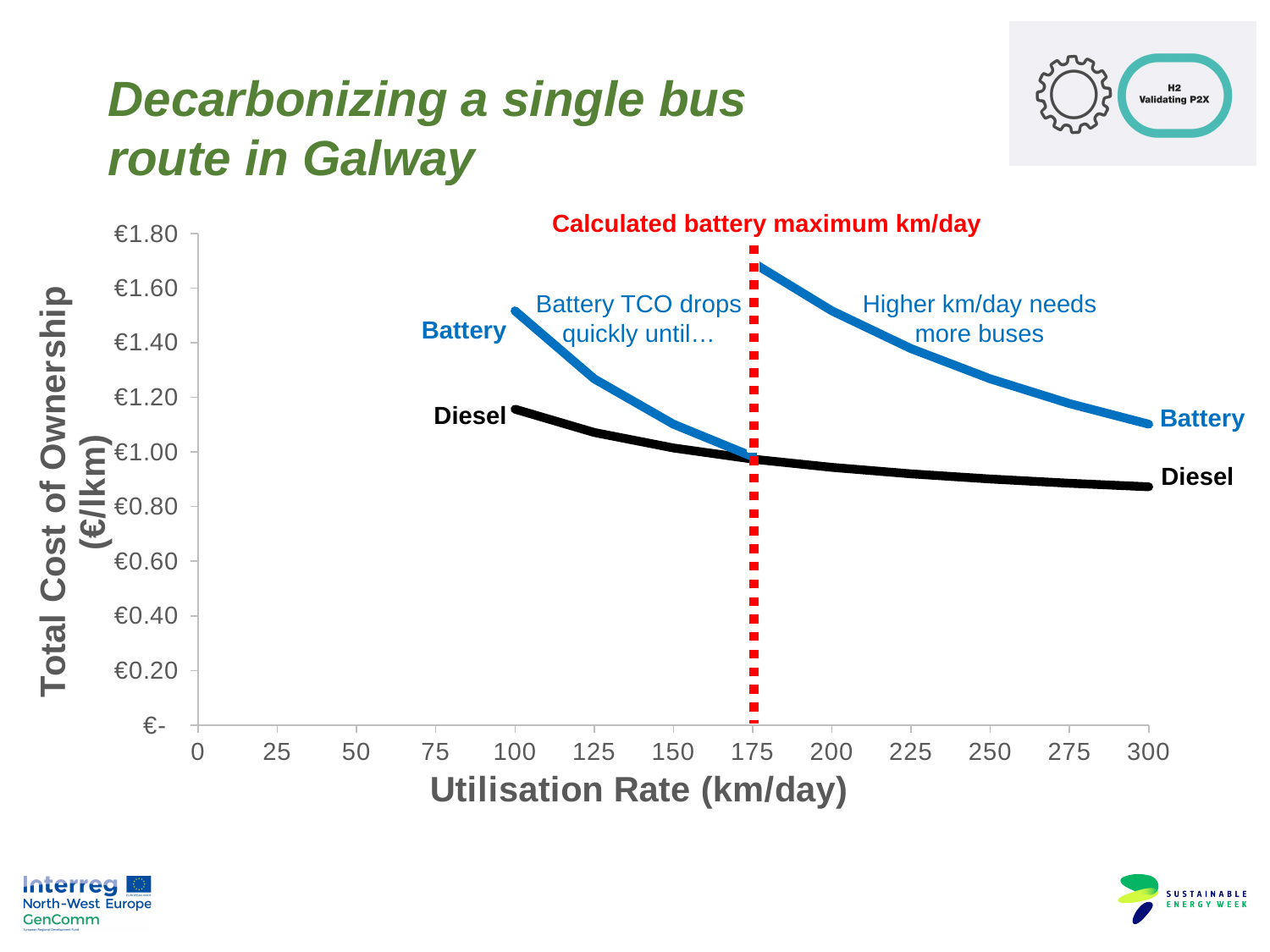
How many series (lines) are plotted on the chart? 2 Is the Battery total cost of ownership at 300 km/day greater or less than €1.00? greater At 100 km/day, which has the higher total cost of ownership, Battery or Diesel? Battery Is the Battery total cost of ownership at 100 km/day greater or less than €1.40? greater Does the Battery total cost of ownership rise or fall as the utilisation rate increases from 175 to 300 km/day? Fall Is the Diesel total cost of ownership at 300 km/day greater or less than €1.00? less At what utilisation rate is the red dashed line marking the calculated battery maximum km/day drawn? 175 Does the Diesel total cost of ownership rise or fall as the utilisation rate increases? Fall At 300 km/day, which has the lower total cost of ownership, Battery or Diesel? Diesel What is the label of the x axis? Utilisation Rate (km/day) What kind of chart is shown on the slide? Line chart